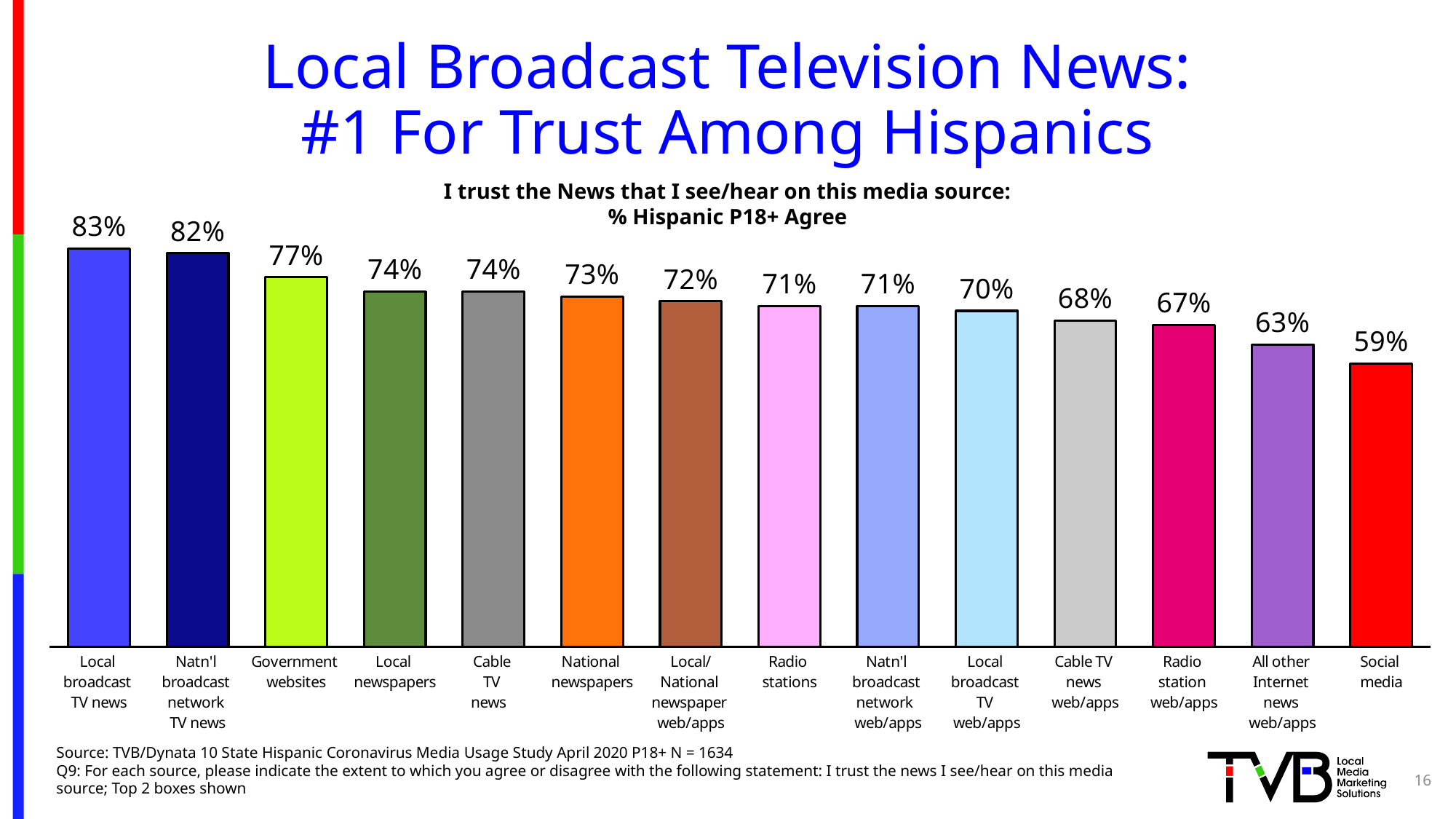
What is the difference between the values for Natn'l broadcast network TV news and Cable TV news web/apps? 14 percentage points Which media source has the lowest trust percentage? Social media What type of chart is shown on the slide? Bar chart What is the chart's title? I trust the News that I see/hear on this media source: % Hispanic P18+ Agree Which has a higher value: National newspapers or All other Internet news web/apps? National newspapers Which media source has the highest trust percentage? Local broadcast TV news How many media sources are shown in the chart? 14 Do the values generally rise or fall moving from left to right across the chart? Fall What is the value shown for Government websites? 77% What percentage is shown for Radio station web/apps? 67% What percentage of Hispanic adults agree they trust the news on Local broadcast TV news? 83% What is the difference between the values for Local broadcast TV news and Social media? 24 percentage points